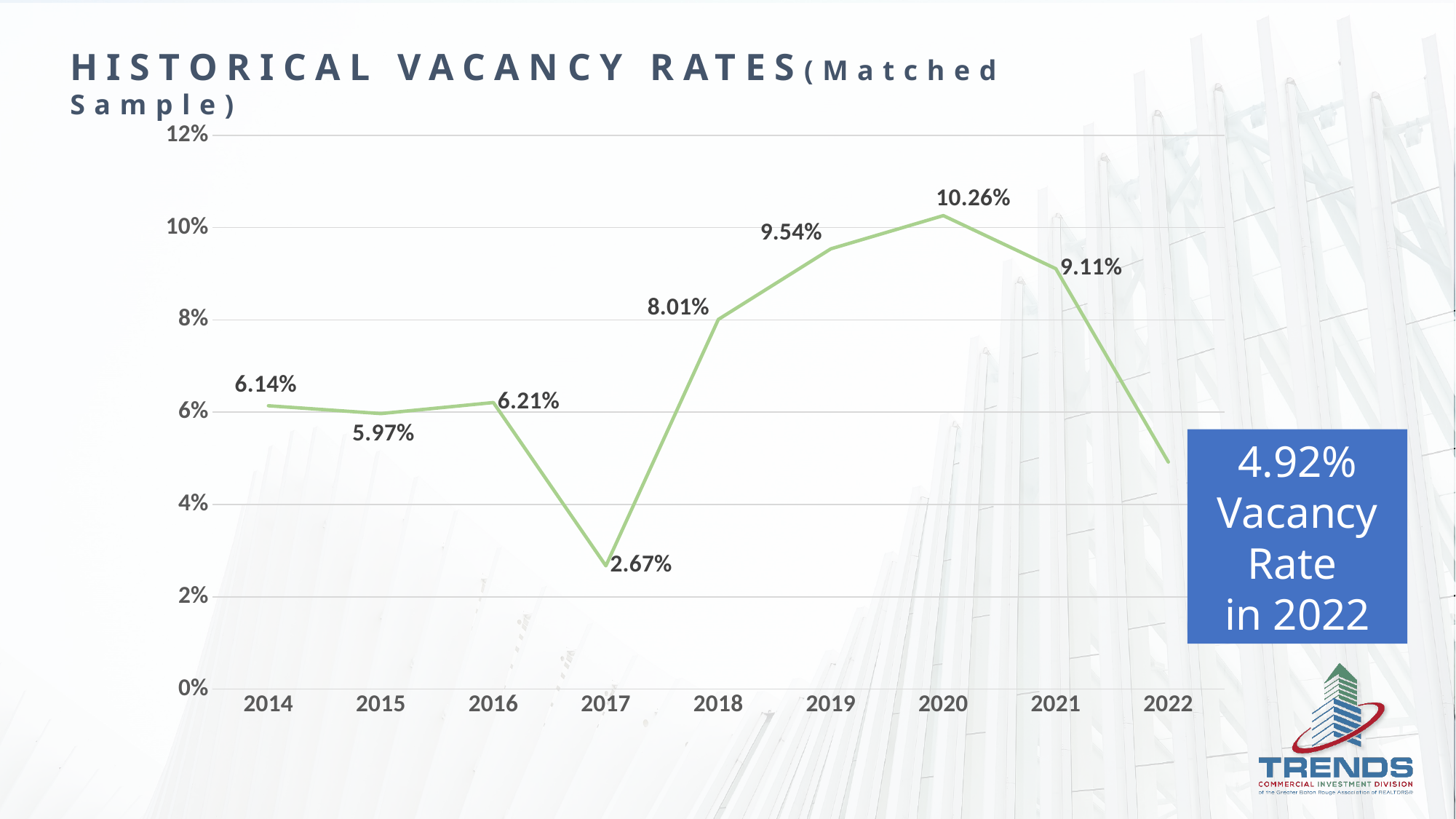
What is the difference between the vacancy rates in 2020 and 2021? 1.15% Which year had the highest vacancy rate? 2020 What was the vacancy rate in 2022? 4.92% Is the vacancy rate for 2021 greater or less than 8%? greater What was the vacancy rate in 2020? 10.26% How many years are plotted on the chart? 9 What is the title of the chart? Historical Vacancy Rates (Matched Sample) Which year had a higher vacancy rate, 2018 or 2019? 2019 What was the vacancy rate in 2017? 2.67% Which year had the lowest vacancy rate? 2017 What kind of chart is shown on the slide? Line chart Did the vacancy rate rise or fall from 2020 to 2022? Fall